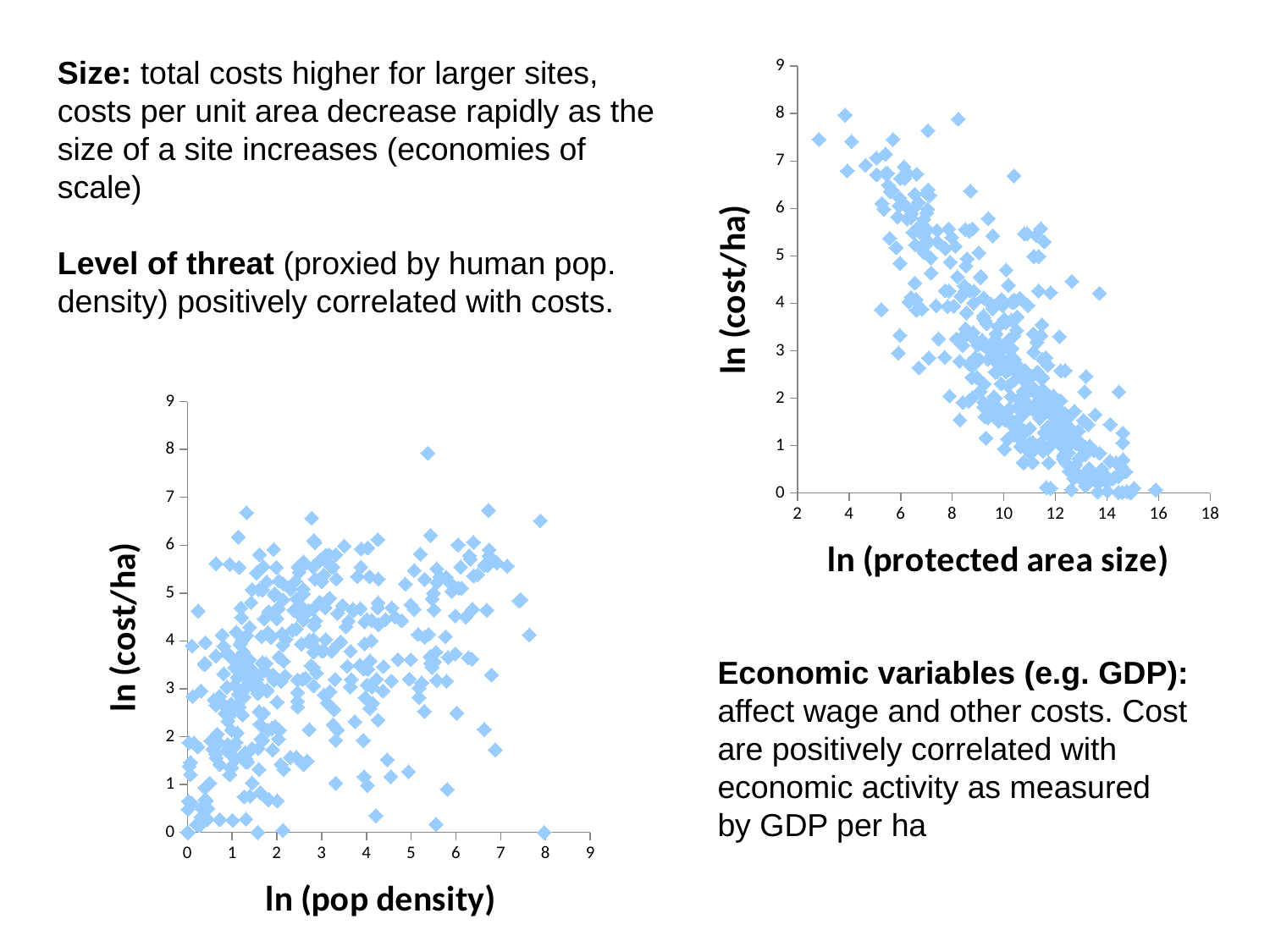
What kind of chart is the chart on the left, with x axis ln (pop density)? scatter chart What is the label of the y axis on the chart on the right? ln (cost/ha) What kind of chart is the chart on the right, with x axis ln (protected area size)? scatter chart What is the label of the x axis on the chart on the left? ln (pop density) In the chart on the left (ln (pop density) on the x axis), do the values of ln (cost/ha) generally rise or fall as ln (pop density) increases? rise In the chart on the right (ln (protected area size) on the x axis), do the values of ln (cost/ha) generally rise or fall as ln (protected area size) increases? fall How many charts are shown on the slide? 2